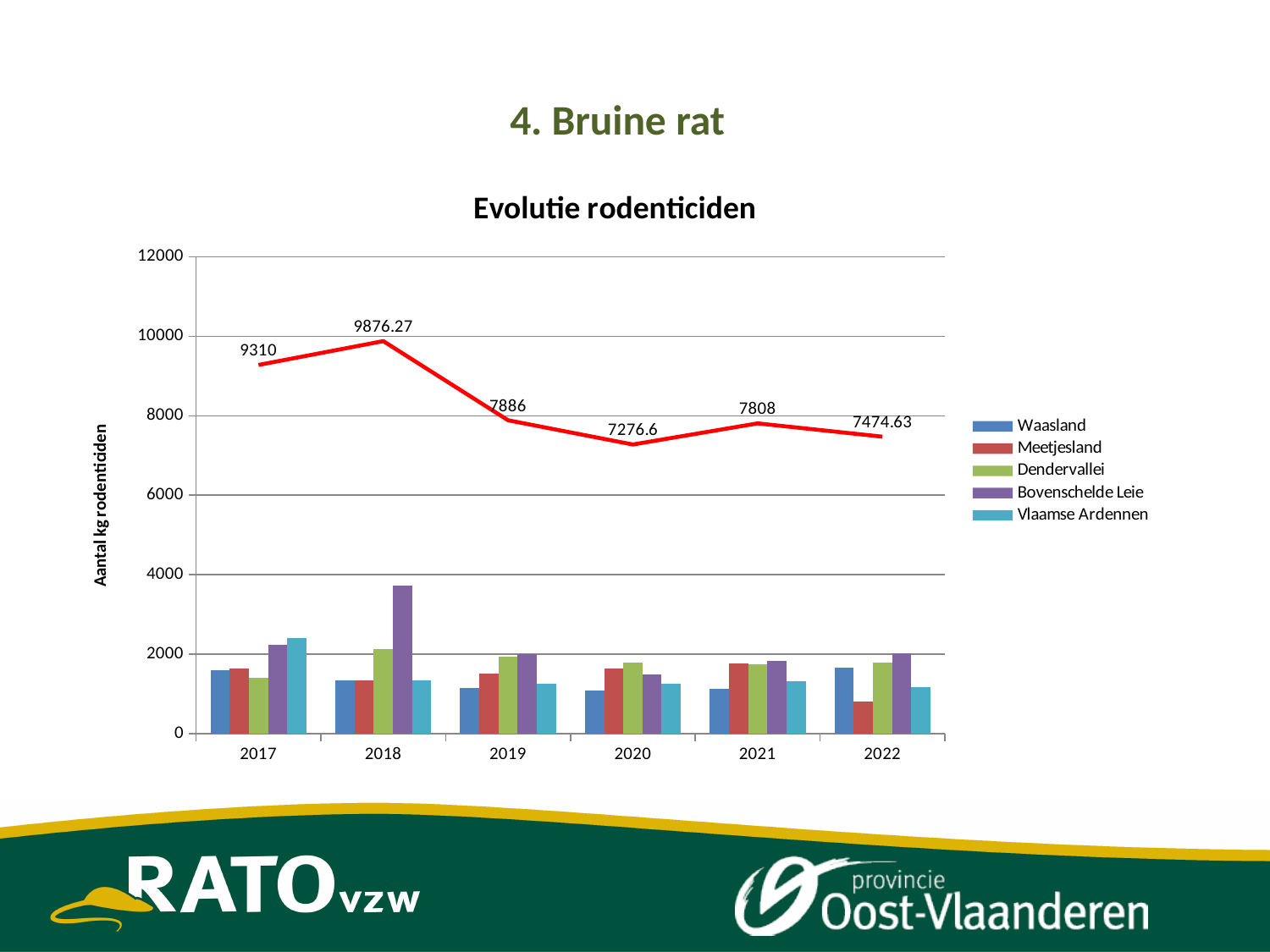
How many years are shown on the x axis? 6 Which is larger, the red line value for 2021 or for 2022? 2021 What is the value shown on the red line for 2022? 7474.63 In which year does the red line reach its highest value? 2018 Is the value for Bovenschelde Leie in 2018 greater or less than 2000? greater What is the value shown on the red line for 2018? 9876.27 In which year does the red line reach its lowest value? 2020 How many series does the legend list? 5 Does the red line rise or fall from 2018 to 2020? Fall What kind of chart is this? Combined bar and line chart What is the difference between the red line values for 2018 and 2017? 566.27 What is the value shown on the red line for 2020? 7276.6